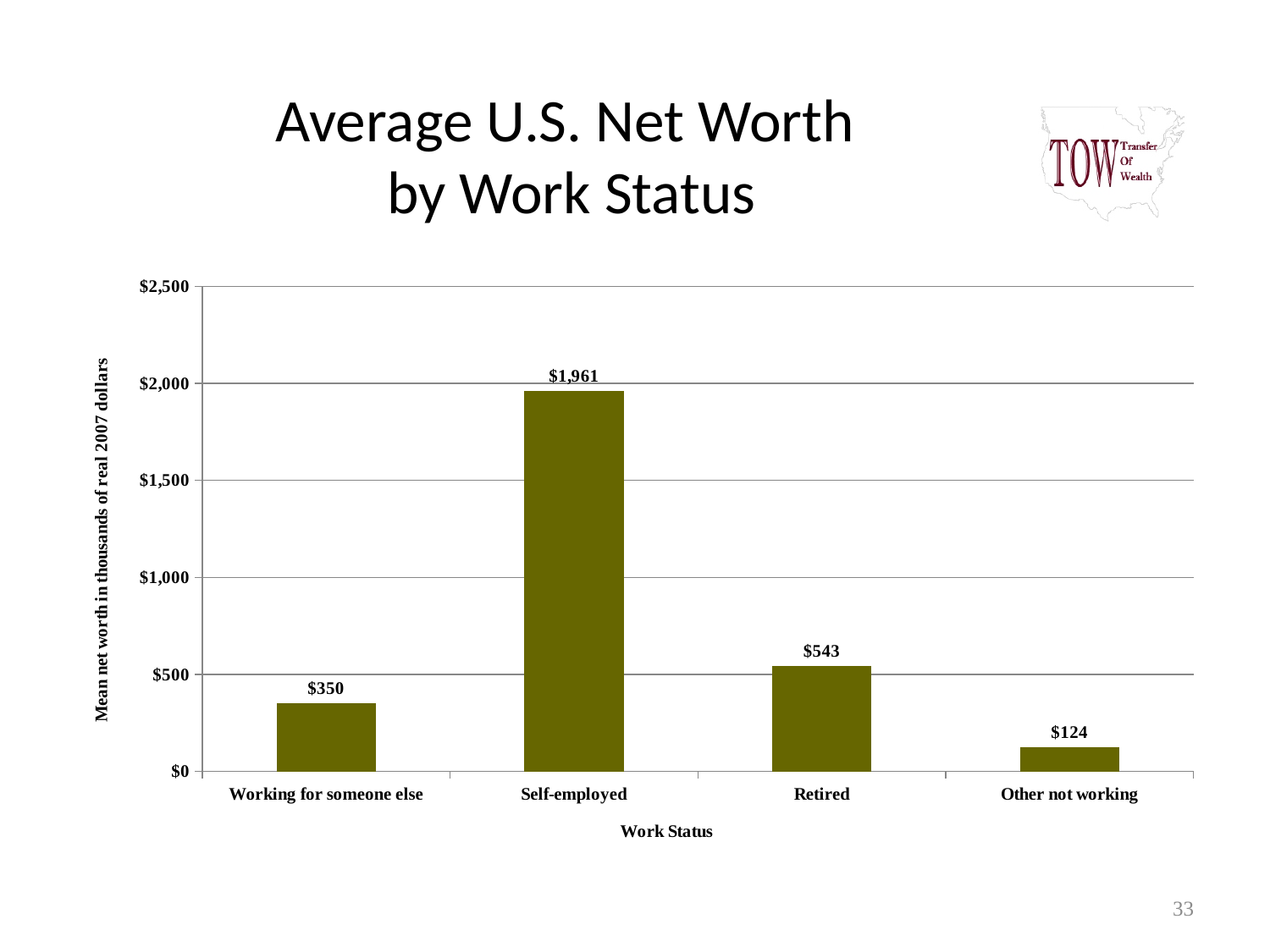
Which work status has the lowest mean net worth? Other not working What is the mean net worth for Working for someone else? $350 What is the mean net worth for Self-employed? $1,961 What is the difference in mean net worth between Self-employed and Retired? $1,418 Which work status has the highest mean net worth? Self-employed What kind of chart is shown on the slide? Bar chart What is the mean net worth for Retired? $543 Which has a higher mean net worth, Retired or Working for someone else? Retired How many work status categories are shown in the chart? 4 What is the label of the vertical axis? Mean net worth in thousands of real 2007 dollars Is the value for Retired greater or less than $500? greater What is the mean net worth for Other not working? $124